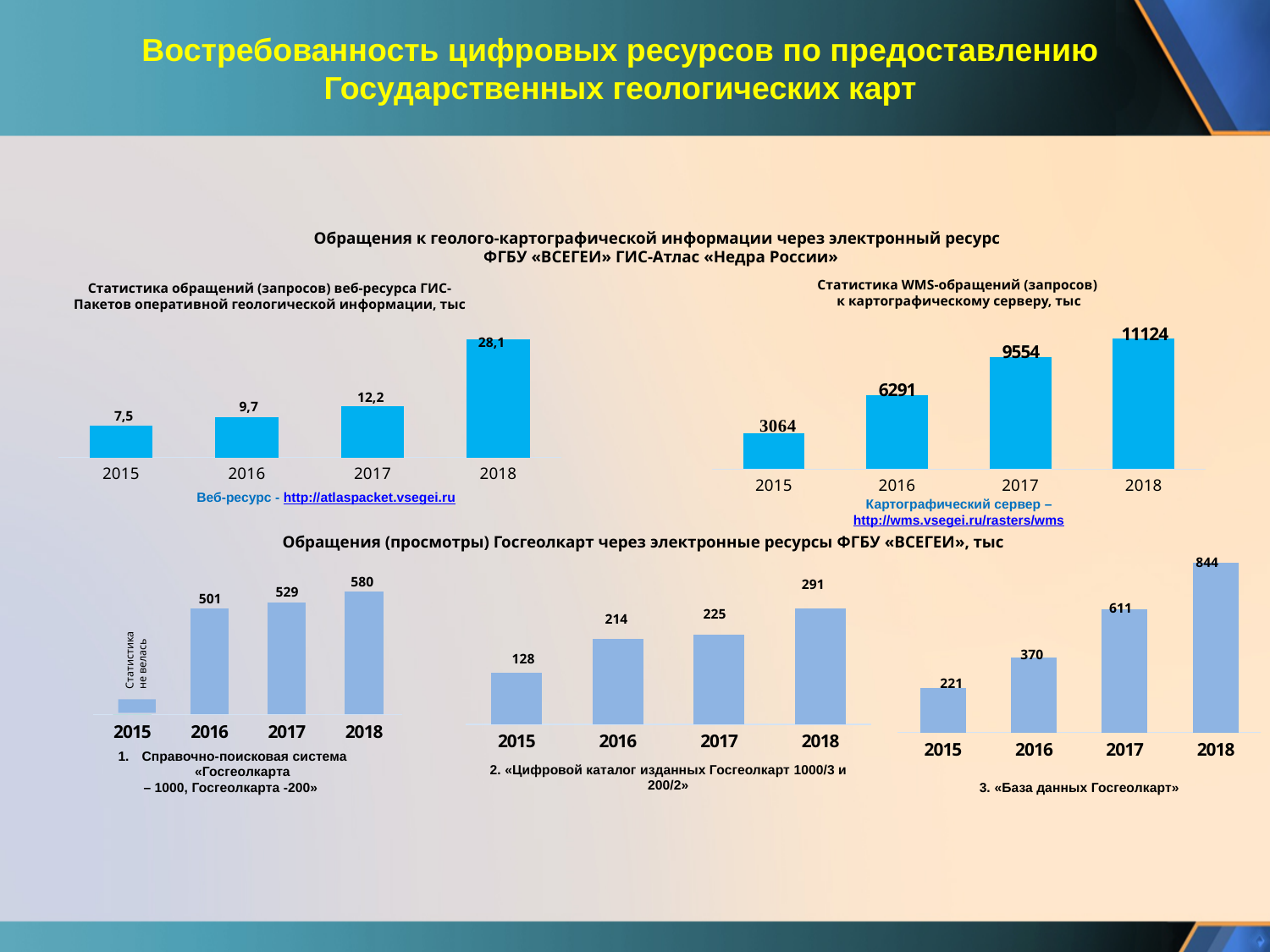
In the bottom-middle chart (Цифровой каталог изданных Госгеолкарт), which year has the lowest value? 2015 In the bottom-right chart (База данных Госгеолкарт), what is the difference between the 2017 and 2016 values? 241 In the bottom-right chart (База данных Госгеолкарт), what is the value for 2018? 844 In the bottom-middle chart (Цифровой каталог изданных Госгеолкарт), what is the value for 2015? 128 In the top-right chart (Статистика WMS-обращений к картографическому серверу), do the values rise or fall from 2015 to 2018? rise In the top-left chart (Статистика обращений веб-ресурса ГИС-Пакетов), what is the value for 2018? 28,1 In the bottom-left chart (Справочно-поисковая система «Госгеолкарта»), what is the value for 2017? 529 In the bottom-left chart (Справочно-поисковая система «Госгеолкарта»), what is shown for 2015 instead of a value? Статистика не велась In the top-right chart (Статистика WMS-обращений к картографическому серверу), what is the value for 2016? 6291 In the top-left chart (Статистика обращений веб-ресурса ГИС-Пакетов), what is the difference between the 2018 and 2017 values? 15,9 In the top-right chart (Статистика WMS-обращений к картографическому серверу), which year has the highest value? 2018 What type of chart is the top-left chart (Статистика обращений веб-ресурса ГИС-Пакетов)? bar chart